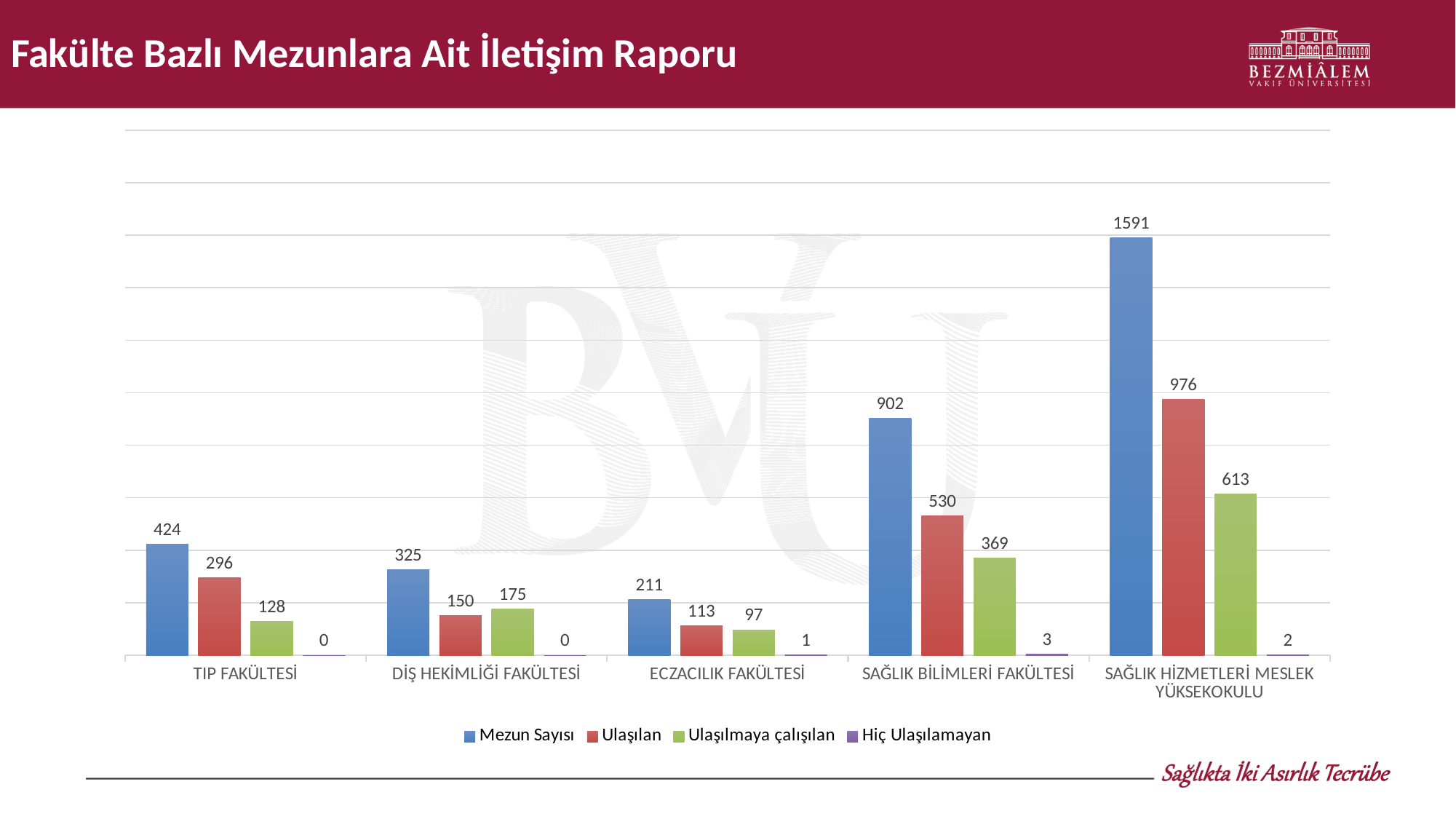
How many series does the legend list? 4 What is the Mezun Sayısı value for SAĞLIK HİZMETLERİ MESLEK YÜKSEKOKULU? 1591 What kind of chart is shown on the slide? Bar chart How many faculties are shown on the x axis? 5 What is the title of the slide? Fakülte Bazlı Mezunlara Ait İletişim Raporu What is the difference between Mezun Sayısı and Ulaşılan for TIP FAKÜLTESİ? 128 What is the Hiç Ulaşılamayan value for ECZACILIK FAKÜLTESİ? 1 Which faculty has the lowest Ulaşılan value? ECZACILIK FAKÜLTESİ Which is larger for DİŞ HEKİMLİĞİ FAKÜLTESİ: Ulaşılan or Ulaşılmaya çalışılan? Ulaşılmaya çalışılan Which faculty has the highest Mezun Sayısı? SAĞLIK HİZMETLERİ MESLEK YÜKSEKOKULU What is the Ulaşılmaya çalışılan value for SAĞLIK BİLİMLERİ FAKÜLTESİ? 369 What is the Ulaşılan value for DİŞ HEKİMLİĞİ FAKÜLTESİ? 150